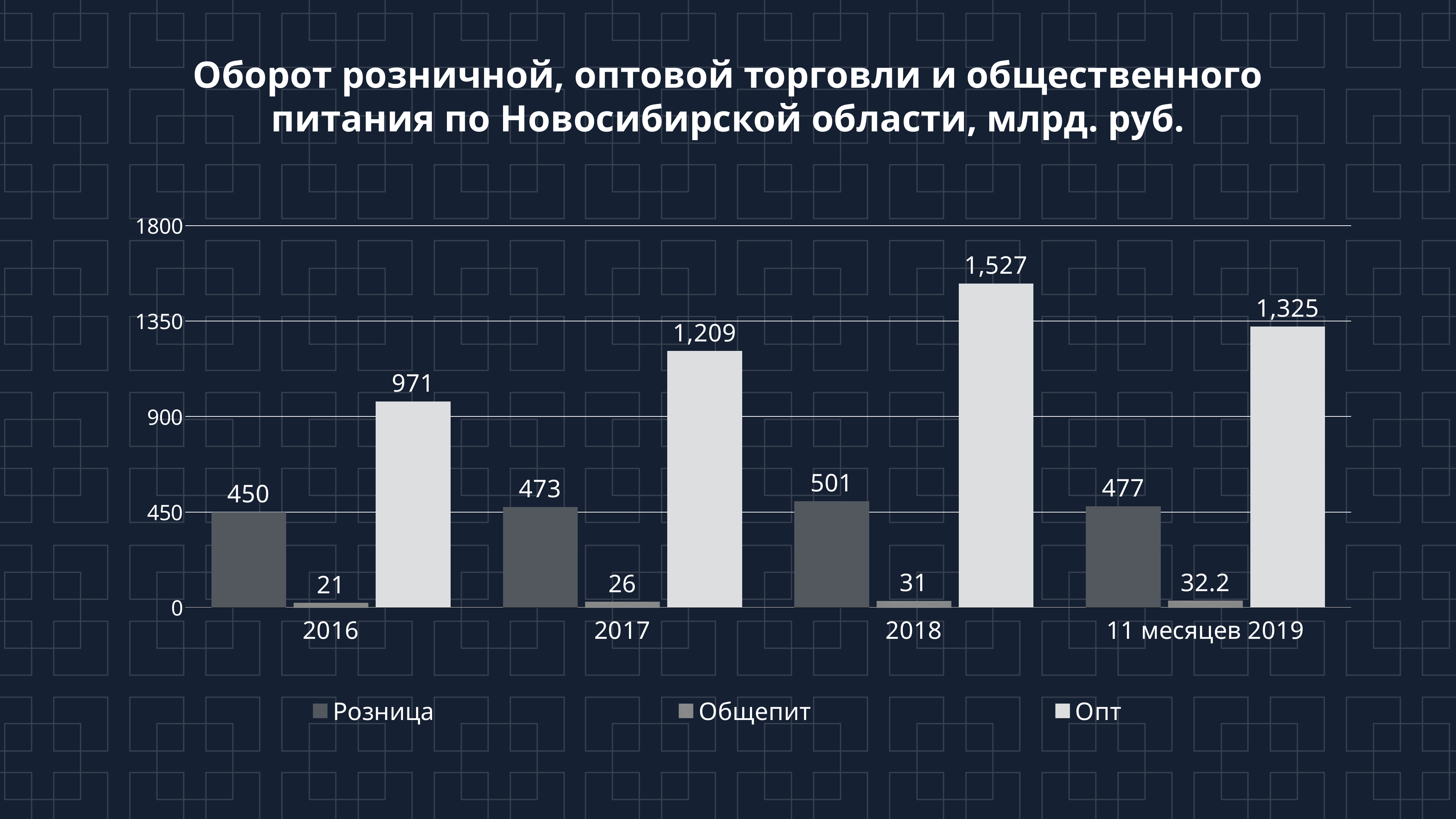
How many series does the legend list? 3 In which period is the Опт value highest? 2018 What is the value for Опт in 2018? 1,527 Is the value for Опт in 2016 greater or less than 900? greater Which is larger: Розница in 2018 or Розница in 11 месяцев 2019? Розница in 2018 Does the Общепит value rise or fall from 2016 to 11 месяцев 2019? rise What is the value for Общепит in 11 месяцев 2019? 32.2 In which period is the Общепит value lowest? 2016 What is the difference between the Опт values for 2018 and 2017? 318 How many periods are shown on the x axis? 4 What is the value for Розница in 2016? 450 What kind of chart is shown on the slide? bar chart